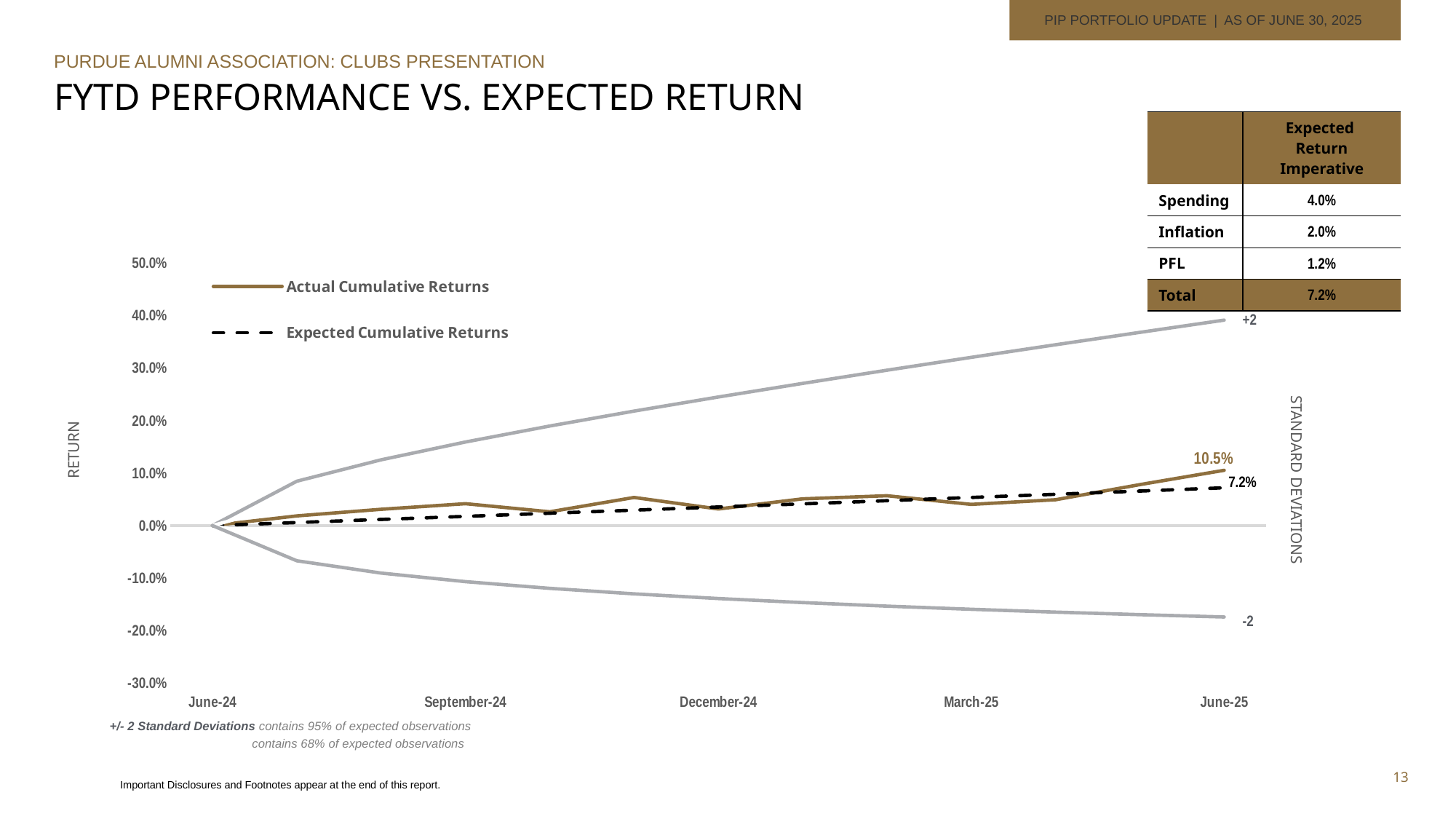
What is the value of Actual Cumulative Returns at June-25? 10.5% Is the -2 standard deviation line at June-25 greater or less than -10.0%? less How many series does the chart legend list? 2 Is the value of Expected Cumulative Returns at June-25 greater or less than 10.0%? less What is the difference between Actual Cumulative Returns and Expected Cumulative Returns at June-25? 3.3% What is the label of the chart's vertical axis? RETURN What is the value of Expected Cumulative Returns at June-25? 7.2% Does the Expected Cumulative Returns line rise or fall from June-24 to June-25? Rise What kind of chart is shown on the slide? Line chart Is the value of Actual Cumulative Returns at June-25 greater or less than 10.0%? greater At June-25, which is larger: Actual Cumulative Returns or Expected Cumulative Returns? Actual Cumulative Returns